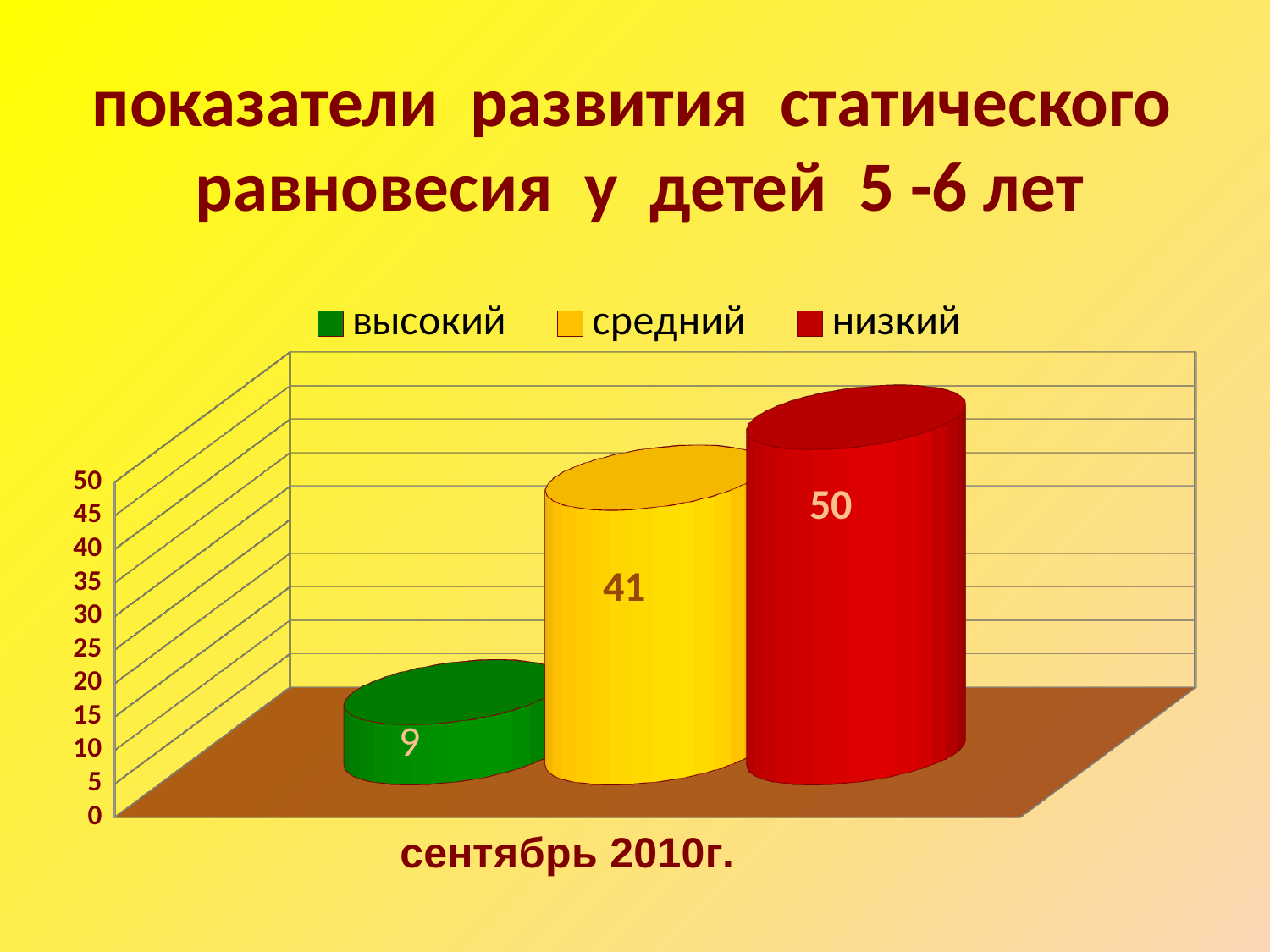
What kind of chart is shown on the slide? bar chart Which series has the highest value? низкий What is the difference between the values for "низкий" and "средний"? 9 What is the value for the series "высокий"? 9 Which series has the lowest value? высокий What is the difference between the values for "средний" and "высокий"? 32 What colour is the bar for the series "низкий"? red What is the value for the series "низкий"? 50 Which is larger, the value for "средний" or the value for "высокий"? средний What is the value for the series "средний"? 41 How many series does the legend list? 3 What is the category label shown below the chart? сентябрь 2010г.